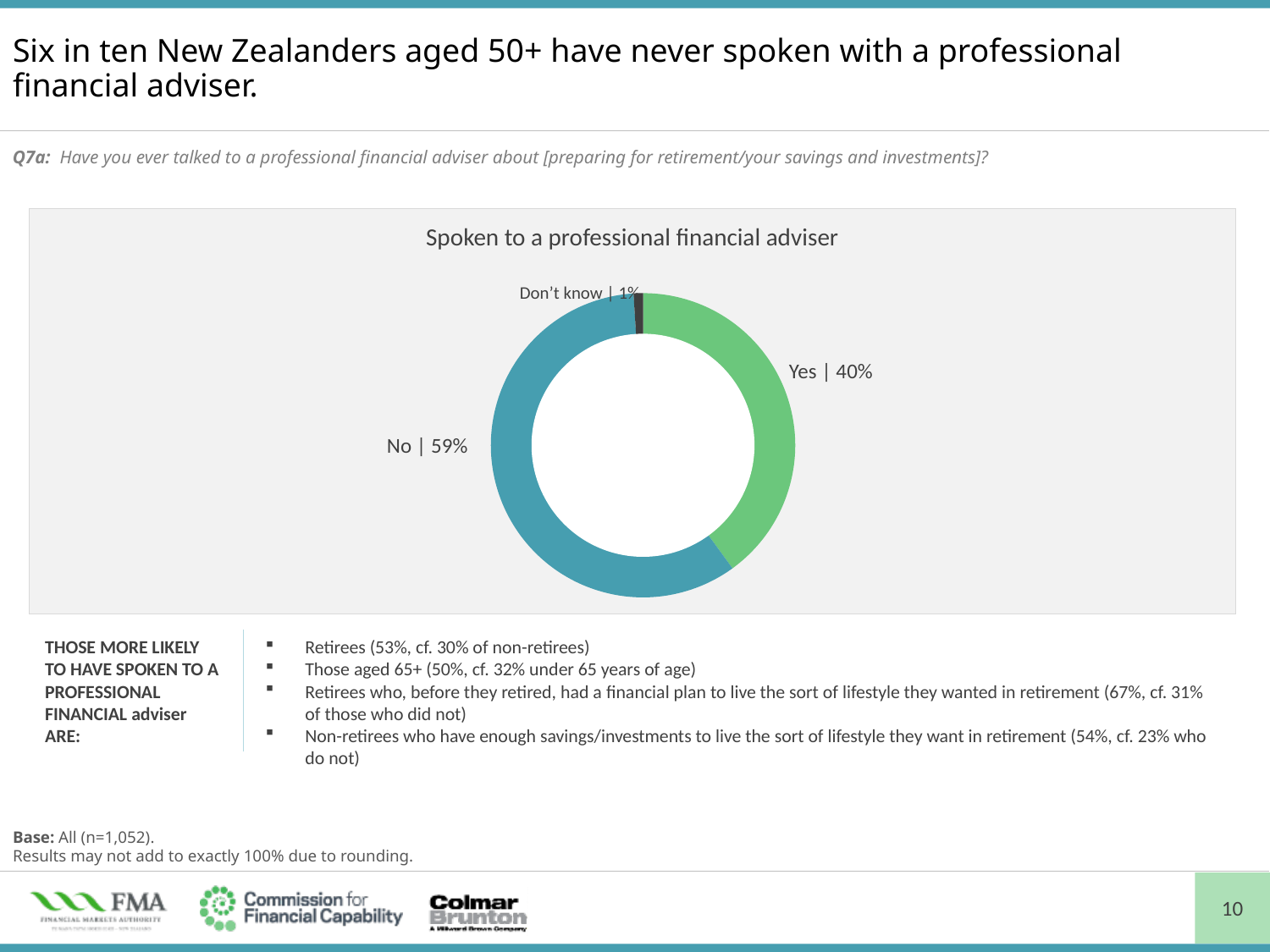
What percentage of respondents answered 'Yes'? 40% What is the title of the chart? Spoken to a professional financial adviser What kind of chart is shown on the slide? Doughnut (pie) chart Which response has the largest share of the chart? No What percentage of respondents answered 'No'? 59% What is the combined share of 'Yes' and 'Don't know'? 41% What percentage of respondents answered 'Don't know'? 1% Which response has the smallest share of the chart? Don't know What is the difference in percentage points between 'No' and 'Yes'? 19 percentage points Which is larger, the share for 'Yes' or the share for 'No'? No How many categories are shown in the chart? 3 What colour is the 'No' segment of the chart? Blue (teal)